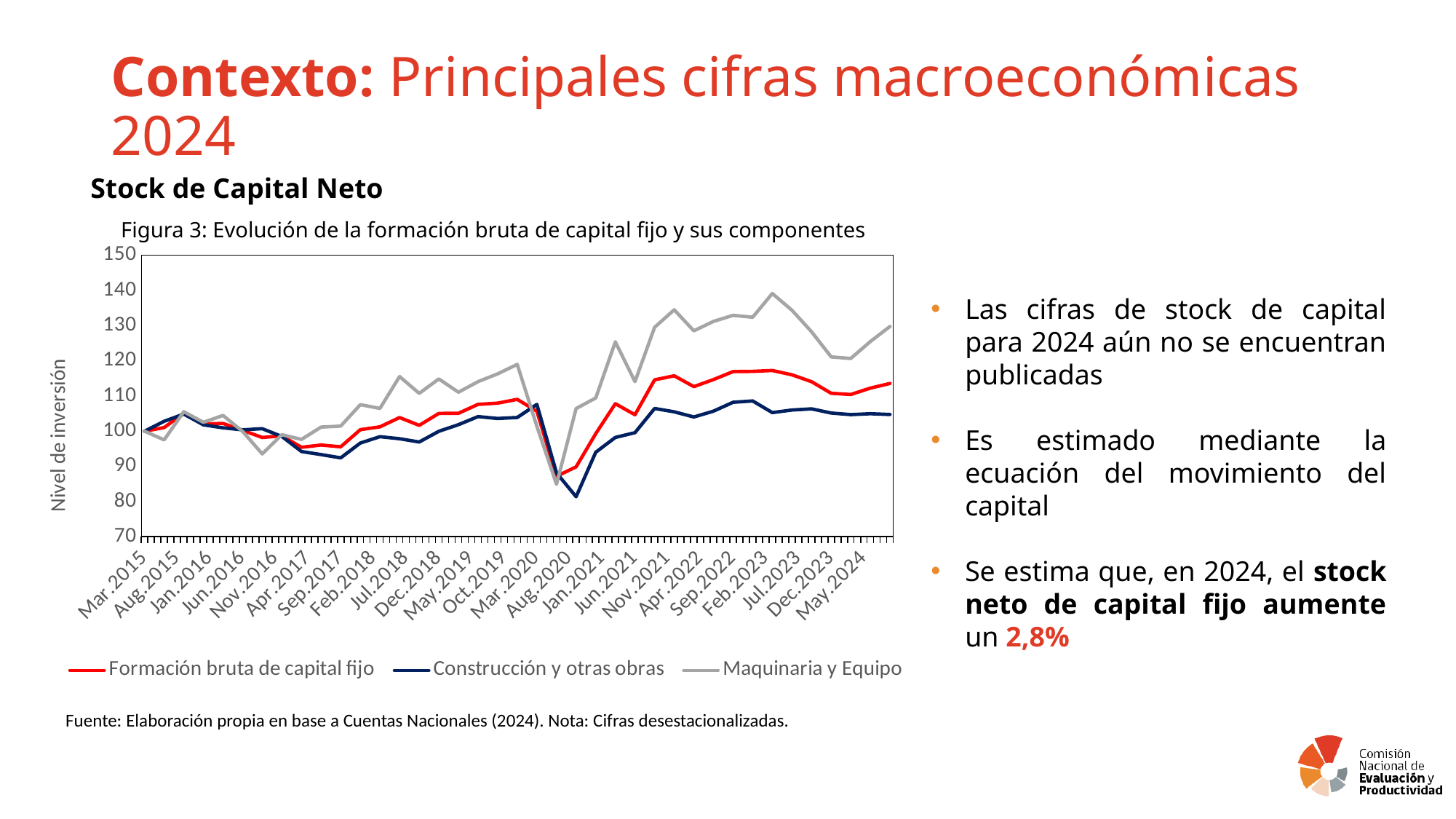
Is the value of Maquinaria y Equipo at Jul.2023 greater or less than 130? greater Does the Formación bruta de capital fijo series rise or fall between Aug.2020 and Jun.2021? Rise Is the value of Construcción y otras obras at Aug.2020 greater or less than 90? less At May.2024, which is larger: Maquinaria y Equipo or Construcción y otras obras? Maquinaria y Equipo Which series has the highest value at Feb.2023? Maquinaria y Equipo Is the value of Formación bruta de capital fijo at Feb.2023 greater or less than 110? greater What kind of chart is shown in Figura 3? Line chart Which series is drawn in red in the chart? Formación bruta de capital fijo How many series does the legend of the chart list? 3 Which series has the lowest value at Aug.2020? Construcción y otras obras What is the label of the vertical axis of the chart? Nivel de inversión